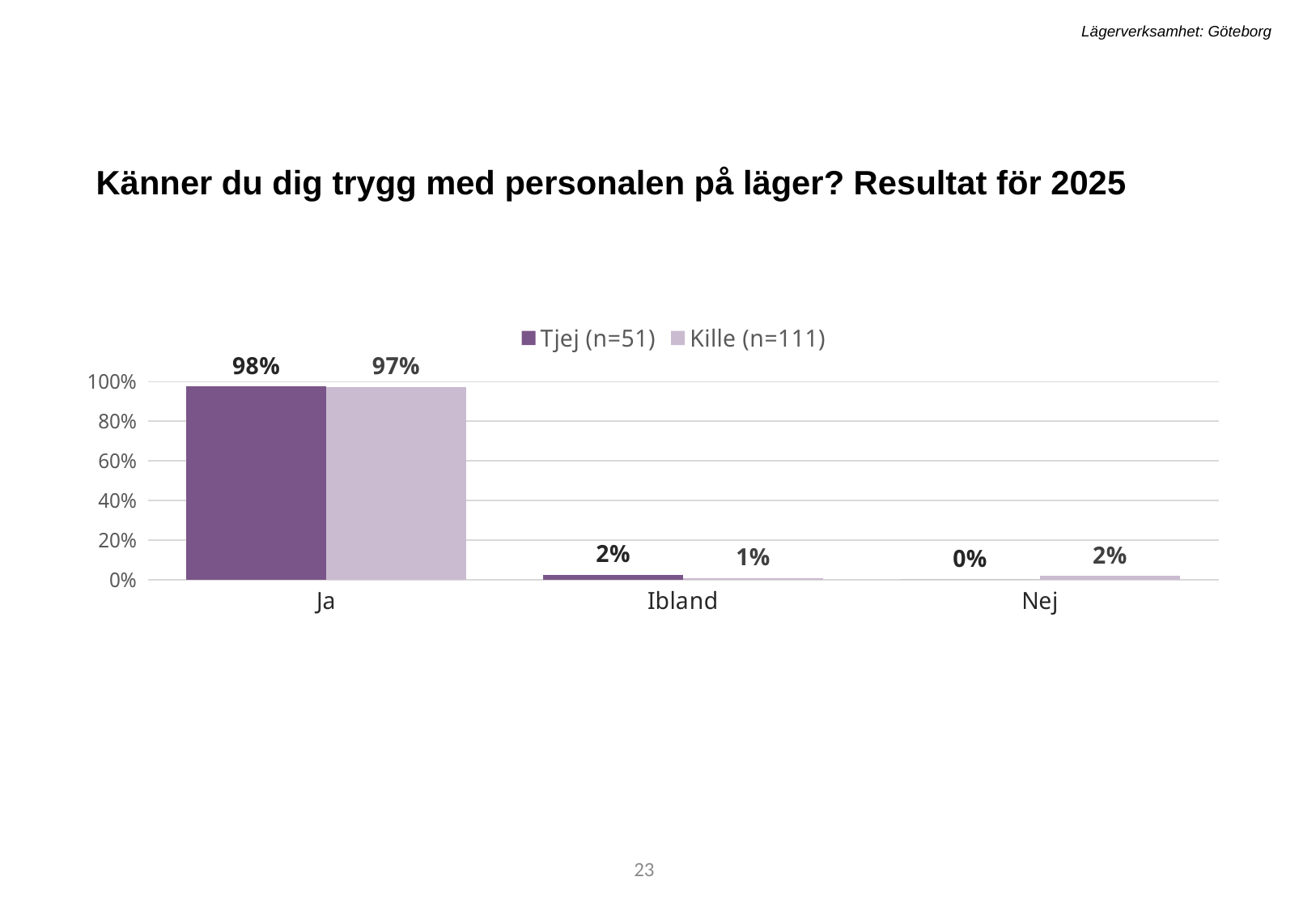
What is the value for Tjej (n=51) in the Ibland category? 2% How many categories are shown on the x axis? 3 What is the difference between the Tjej (n=51) and Kille (n=111) values in the Ja category? 1% What kind of chart is shown on the slide? bar chart What is the value for Kille (n=111) in the Nej category? 2% Is the value for Tjej (n=51) in the Ja category greater or less than 80%? greater Which category has the highest value for Kille (n=111)? Ja What is the value for Kille (n=111) in the Ja category? 97% What is the value for Tjej (n=51) in the Ja category? 98% How many series does the legend list? 2 What is the value for Tjej (n=51) in the Nej category? 0% Which category has the lowest value for Tjej (n=51)? Nej